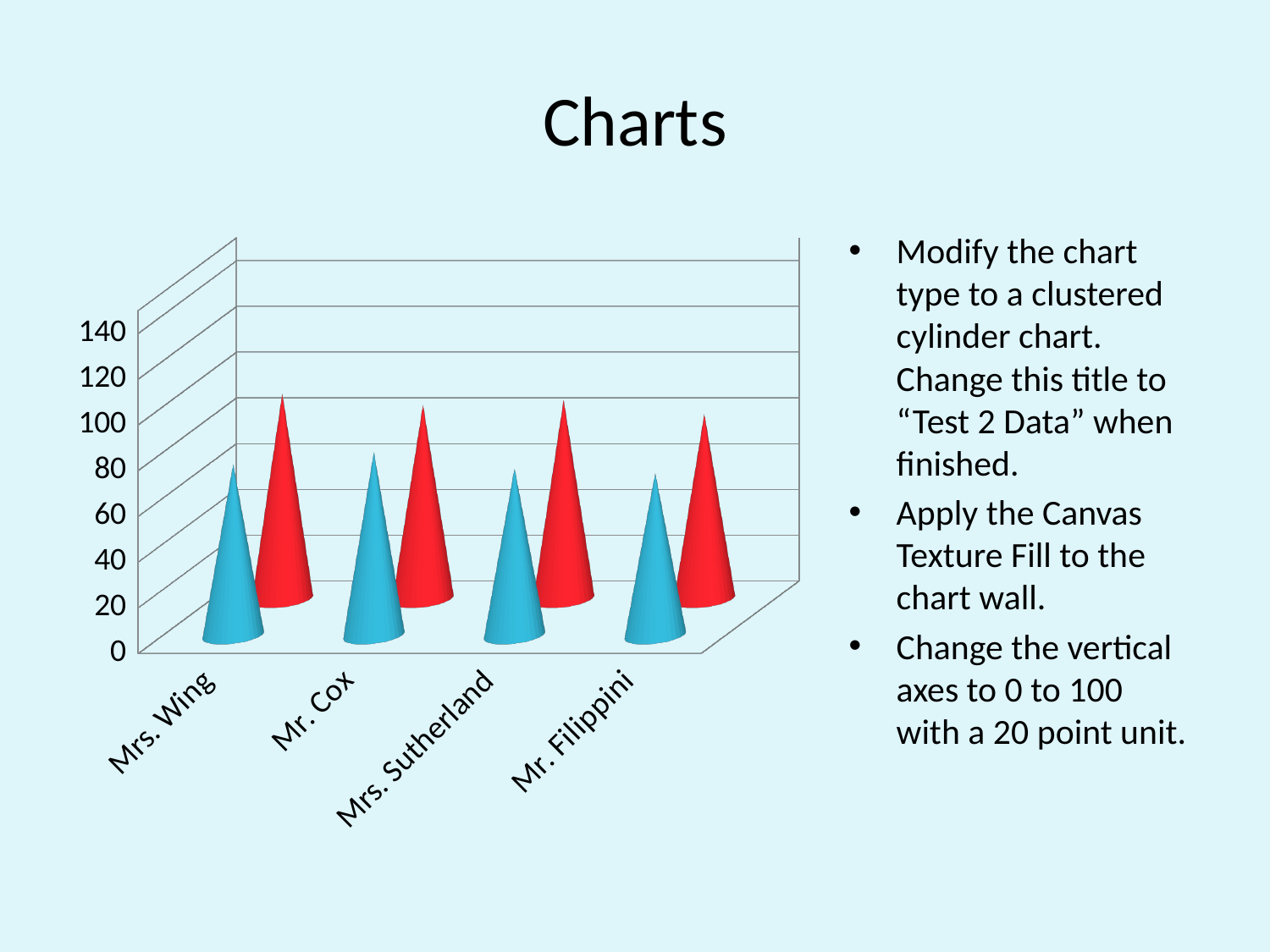
What kind of chart is shown on the slide? bar chart Is the value of the red bar for Mrs. Sutherland greater or less than 40? greater Is the value of the blue bar for Mr. Filippini greater or less than 100? less Is the value of the red bar for Mrs. Wing greater or less than 60? greater How many categories are shown along the horizontal axis of the chart? 4 Which category is listed first on the horizontal axis of the chart? Mrs. Wing What is the highest value shown on the vertical axis of the chart? 140 Which is larger, the blue bar for Mr. Cox or the blue bar for Mr. Filippini? the blue bar for Mr. Cox For Mr. Cox, which bar is larger, the blue one or the red one? the red one For Mr. Filippini, which bar is larger, the blue one or the red one? the red one